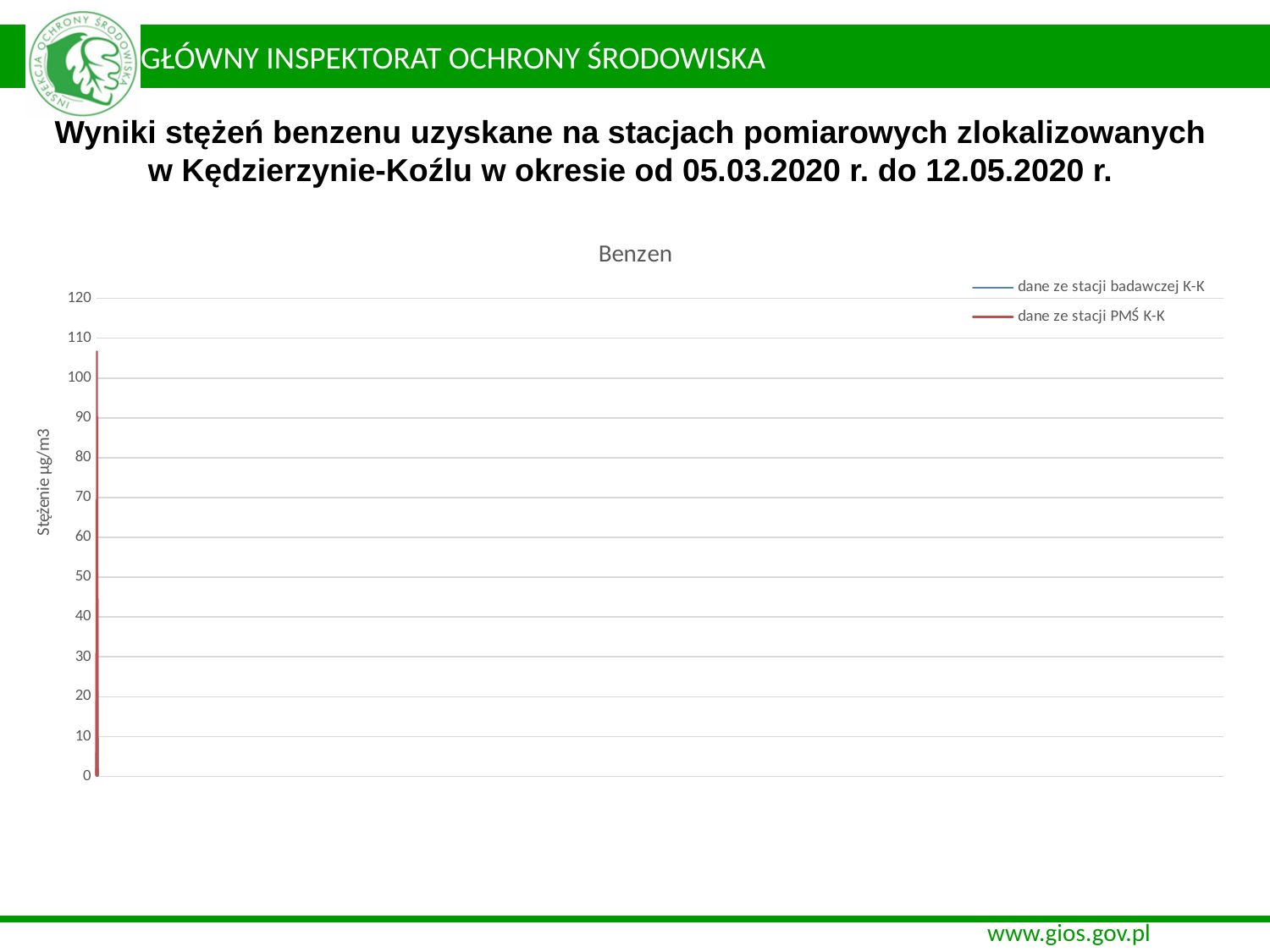
What is the lowest tick value shown on the vertical axis of the chart? 0 What is the title of the chart? Benzen What is the highest tick value shown on the vertical axis of the chart? 120 How many series does the legend of the chart list? 2 What is the label of the vertical axis of the chart? Stężenie µg/m3 Is the peak value of the series 'dane ze stacji PMŚ K-K' greater or less than 100? greater Is the peak value of the series 'dane ze stacji PMŚ K-K' greater or less than 110? less What kind of chart is shown on the slide? line chart